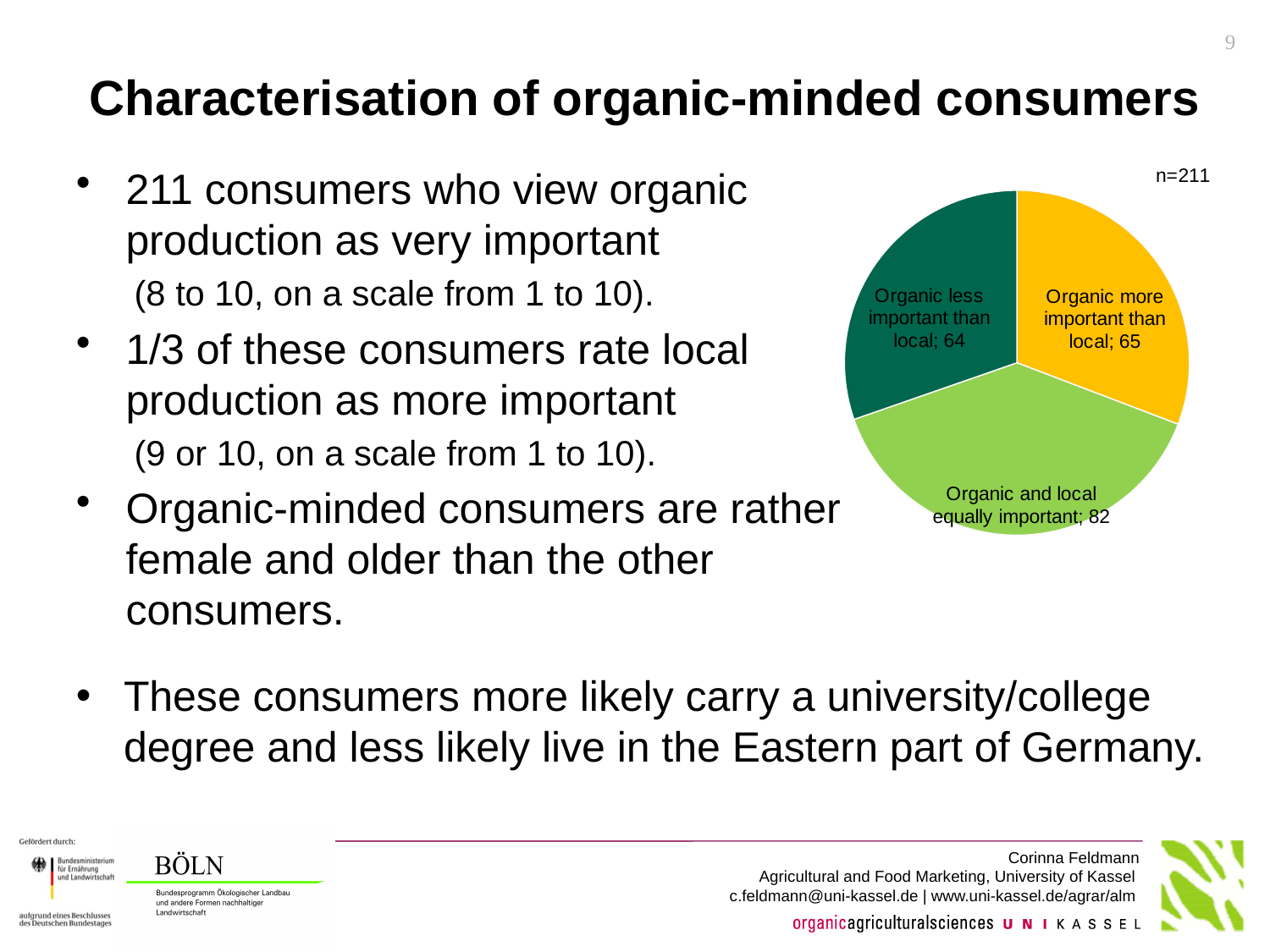
What is the difference between the 'Organic and local equally important' slice and the 'Organic more important than local' slice? 17 What is the value for the slice 'Organic less important than local'? 64 How many slices does the pie chart have? 3 What kind of chart is shown on the slide? pie chart What is the total number of consumers represented in the pie chart (n)? 211 Which is larger: 'Organic and local equally important' or 'Organic less important than local'? Organic and local equally important What is the difference between the 'Organic and local equally important' slice and the 'Organic less important than local' slice? 18 Which slice of the pie chart is the largest? Organic and local equally important Rounded to the nearest whole percent, what share of the pie does 'Organic and local equally important' represent? 39% What colour is the 'Organic more important than local' slice? yellow What is the value for the slice 'Organic and local equally important'? 82 What is the value for the slice 'Organic more important than local'? 65